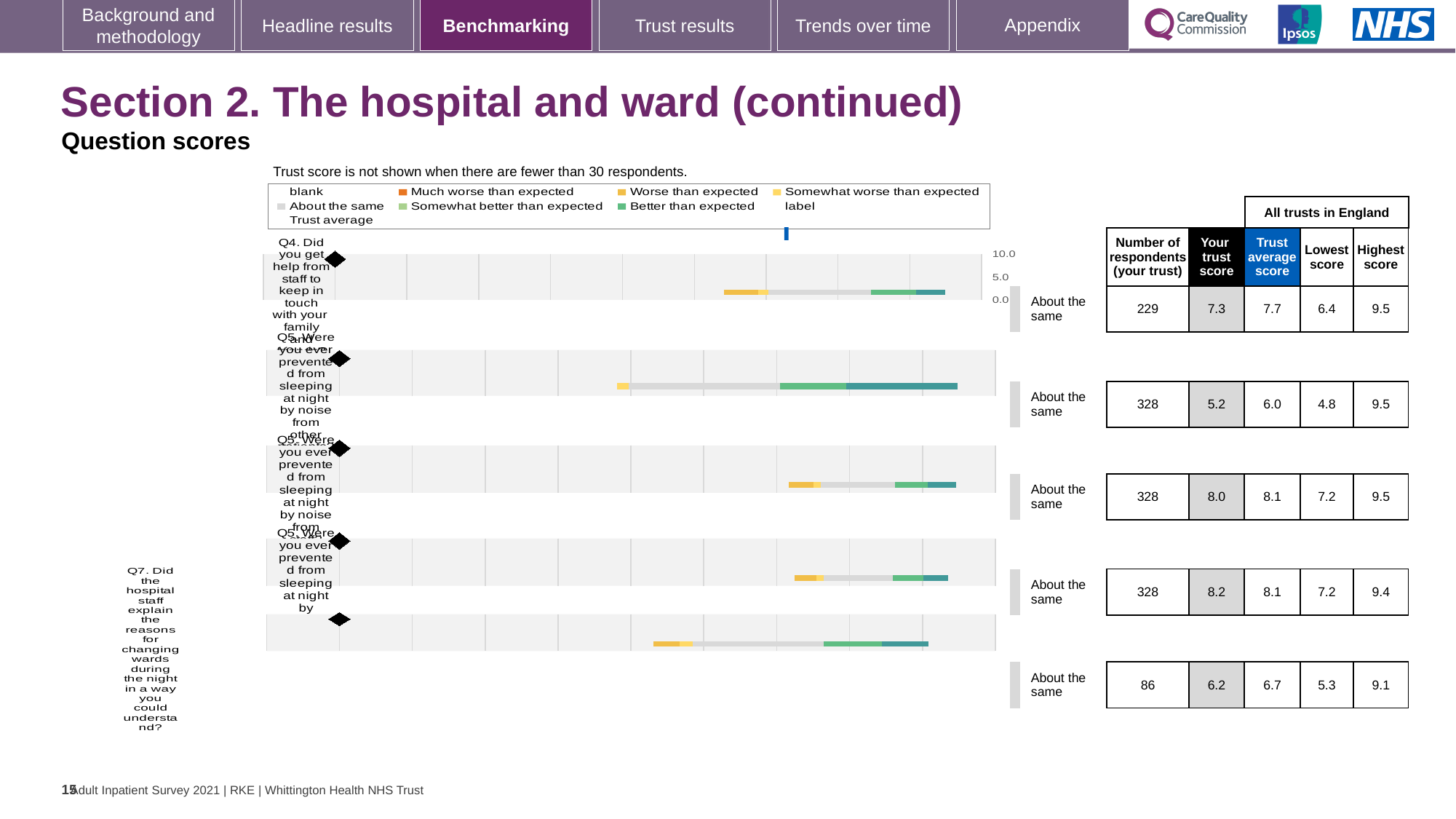
What is the highest 'Your trust score' value shown in the table? 8.2 According to the note above the chart, when is the trust score not shown? When there are fewer than 30 respondents How many respondents from your trust answered Q7 (explaining reasons for changing wards during the night)? 86 What benchmark category label is shown next to every question row on the chart? About the same For Q4, what is the difference between the trust average score (7.7) and your trust score (7.3)? 0.4 What is the highest score across all trusts in England for Q7? 9.1 What kind of chart is used to show the question scores on this slide? bar chart What is the lowest 'Your trust score' value shown in the table? 5.2 How many question rows are plotted on the chart? 5 For Q7, which is larger: your trust score or the trust average score? Trust average score (6.7) For Q7, what is the difference between the highest score (9.1) and the lowest score (5.3)? 3.8 What is the 'Your trust score' value for Q4 (help from staff to keep in touch with family and friends)? 7.3